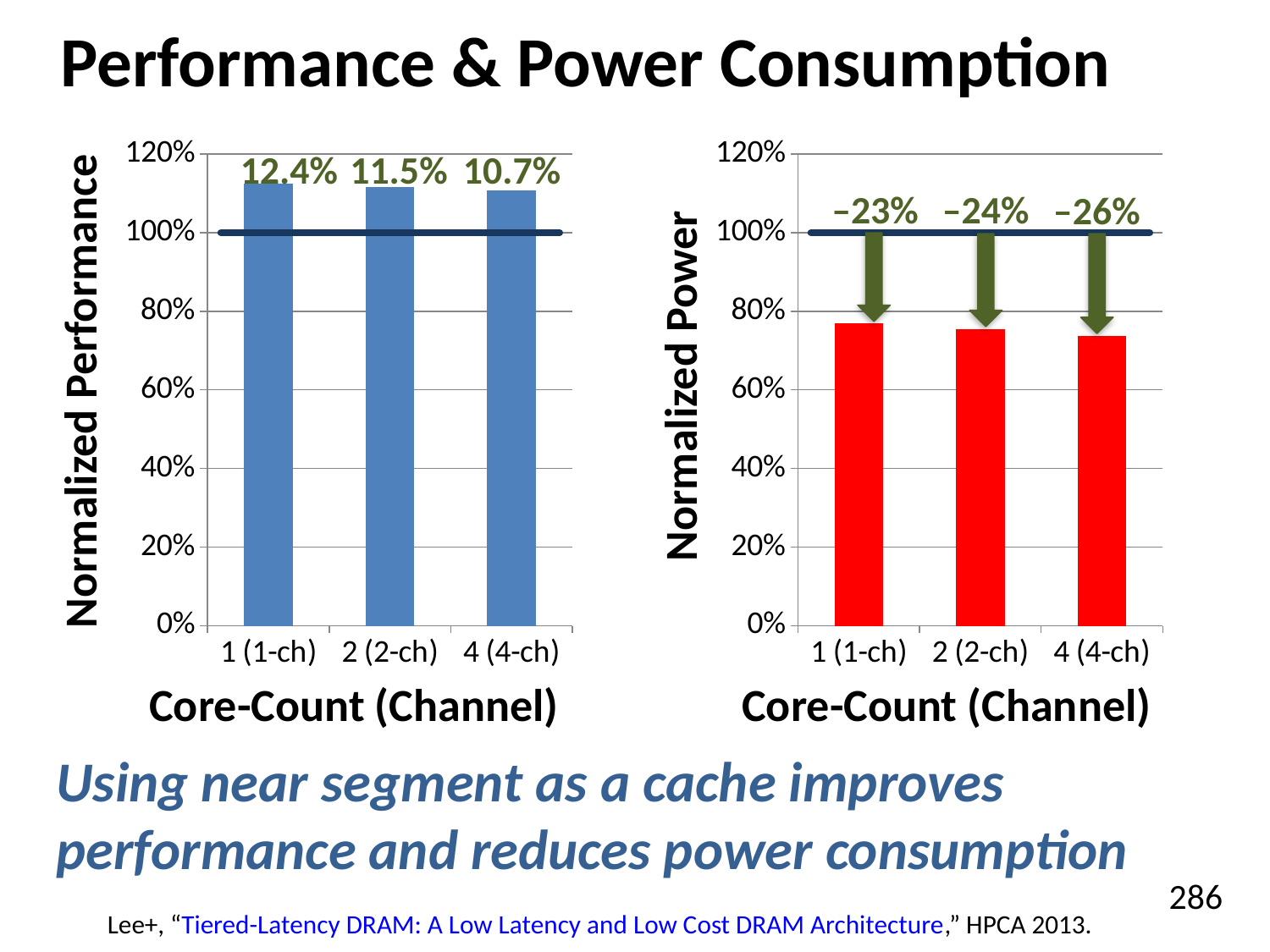
On the Normalized Power chart (right), what label is printed above the bar for 2 (2-ch)? –24% On the Normalized Performance chart (left), which category has the largest printed improvement label? 1 (1-ch) On the Normalized Performance chart (left), what is the difference between the printed labels for 1 (1-ch) and 4 (4-ch)? 1.7% On the Normalized Power chart (right), what label is printed above the bar for 4 (4-ch)? –26% How many categories are shown on the x axis of the Normalized Power chart (right)? 3 On the Normalized Performance chart (left), what label is printed above the bar for 1 (1-ch)? 12.4% On the Normalized Performance chart (left), what label is printed above the bar for 4 (4-ch)? 10.7% On the Normalized Performance chart (left), is the bar for 2 (2-ch) greater or less than 100%? greater On the Normalized Power chart (right), do the bar heights rise or fall from 1 (1-ch) to 4 (4-ch)? Fall What kind of chart is the Normalized Performance chart (left)? Bar chart On the Normalized Power chart (right), which category has the largest printed power reduction label? 4 (4-ch) On the Normalized Power chart (right), is the bar for 1 (1-ch) greater or less than 80%? less